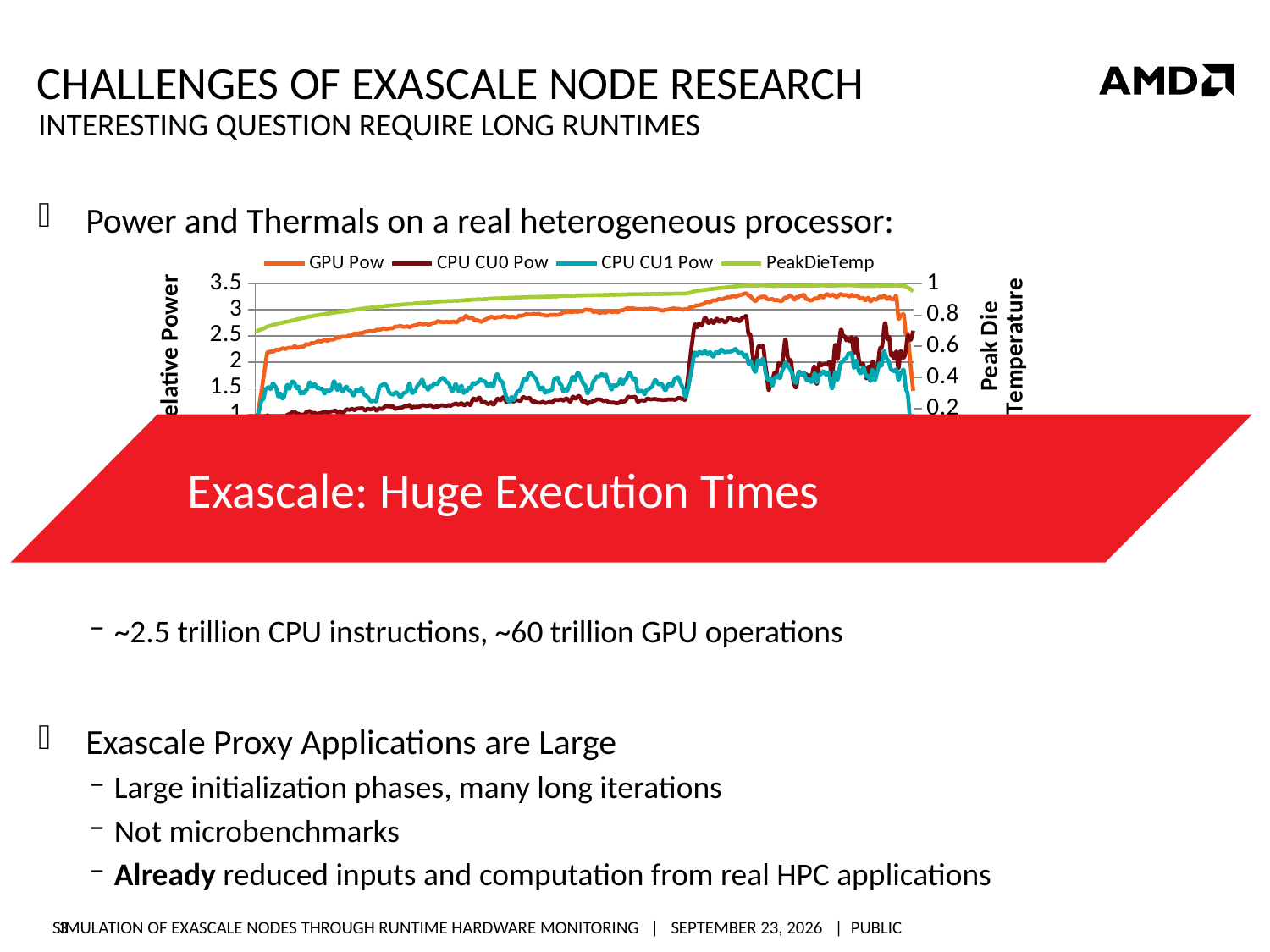
What is the label of the left vertical axis of the chart? Relative Power Which of the three power series reaches the highest relative power on the chart? GPU Pow Is the highest value of PeakDieTemp greater or less than 0.8 on the Peak Die Temperature axis? greater Is the peak value of CPU CU1 Pow greater or less than 2.5 on the Relative Power axis? less Which series are listed in the chart's legend? GPU Pow, CPU CU0 Pow, CPU CU1 Pow, PeakDieTemp Does the PeakDieTemp series generally rise or fall along the x axis? rise Is the peak value of CPU CU0 Pow greater or less than 2.5 on the Relative Power axis? greater Which of the three power series has the lowest values at the start of the chart? CPU CU0 Pow What kind of chart is shown on the slide? line chart How many series does the chart's legend list? 4 Which is higher across the chart, GPU Pow or CPU CU1 Pow? GPU Pow